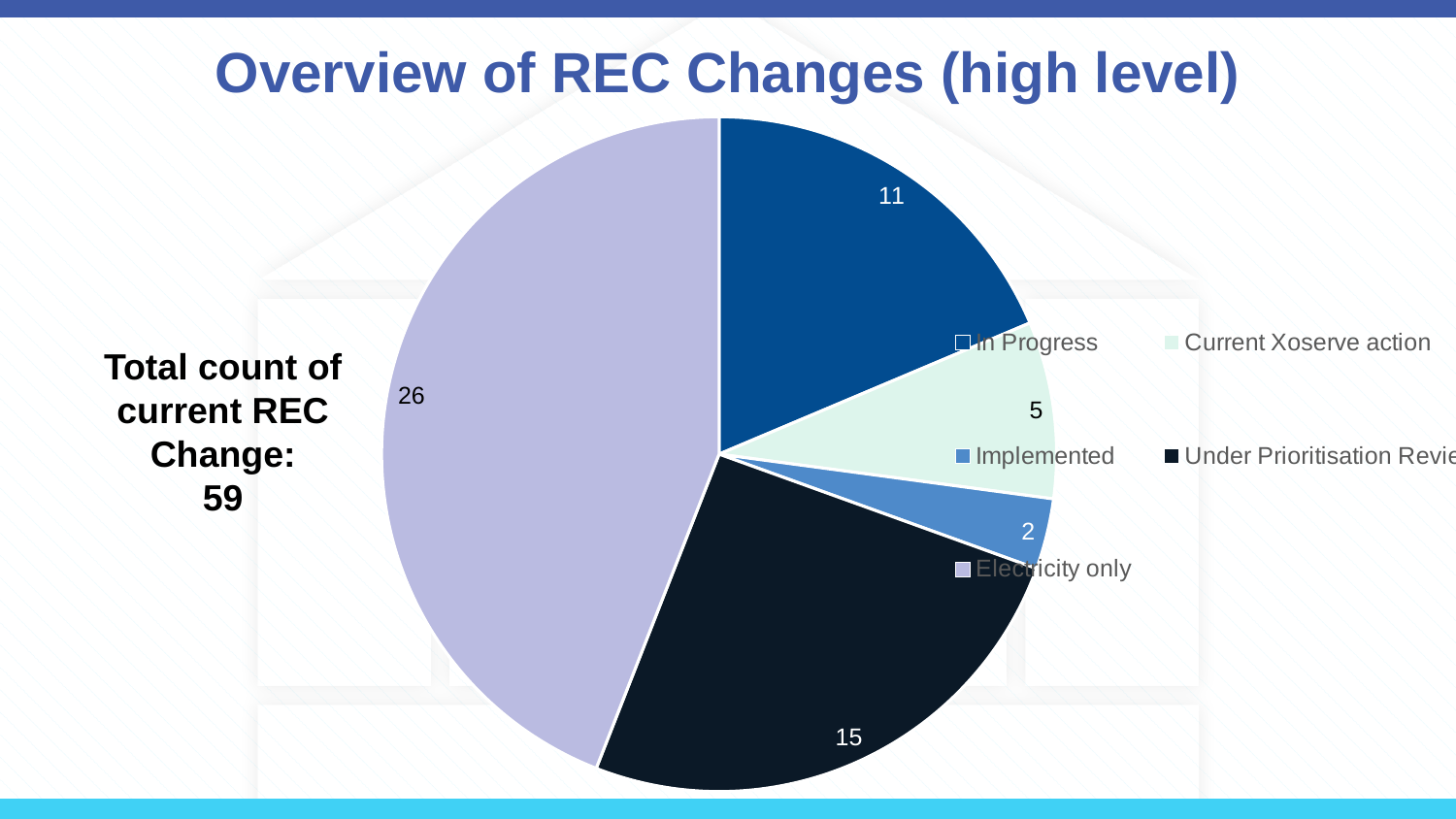
How many slices does the pie chart have? 5 What type of chart is shown on the slide? pie chart What is the value of the In Progress slice? 11 What is the title of the slide containing the pie chart? Overview of REC Changes (high level) What is the total count of current REC Changes stated on the slide? 59 Which category has the smallest slice of the pie? Implemented Which category has the largest slice of the pie? Electricity only Which is larger, the In Progress slice or the Current Xoserve action slice? In Progress What is the value of the Current Xoserve action slice? 5 What is the difference between the Electricity only value and the In Progress value? 15 What is the value of the Electricity only slice? 26 What is the value of the Implemented slice? 2